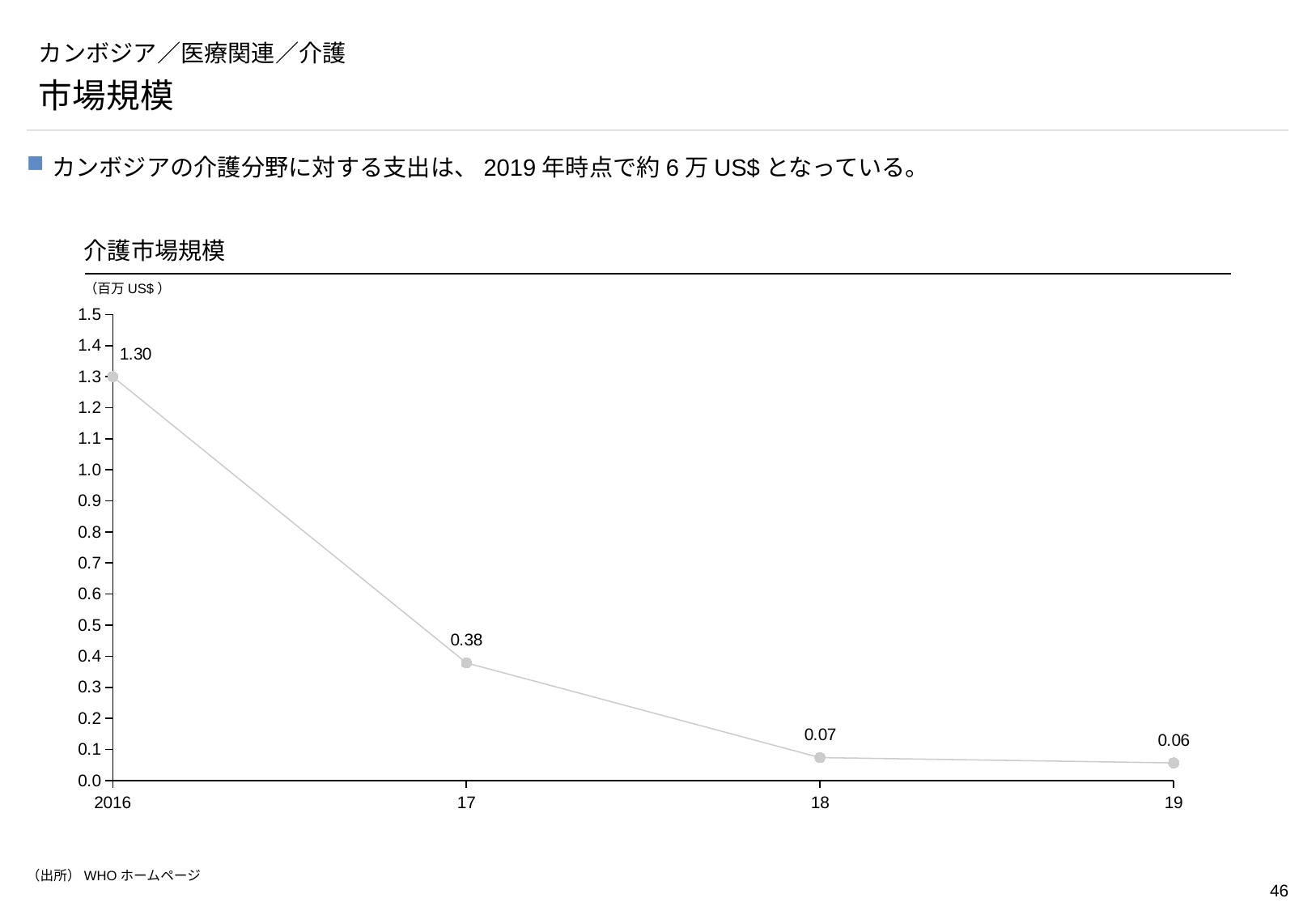
What is the value for 18 (2018) in the 介護市場規模 chart? 0.07 Do the values in the 介護市場規模 chart rise or fall from 2016 to 19? fall How many data points are plotted in the 介護市場規模 chart? 4 What is the value for 19 (2019) in the 介護市場規模 chart? 0.06 What is the difference between the 2016 value and the 17 value in the 介護市場規模 chart? 0.92 What is the value for 2016 in the 介護市場規模 chart? 1.30 Is the value for 17 in the 介護市場規模 chart greater or less than 0.5? less Which is larger in the 介護市場規模 chart, the value for 17 or the value for 18? 17 Which year has the lowest value in the 介護市場規模 chart? 19 Which year has the highest value in the 介護市場規模 chart? 2016 What kind of chart is the 介護市場規模 chart? line chart What is the value for 17 (2017) in the 介護市場規模 chart? 0.38